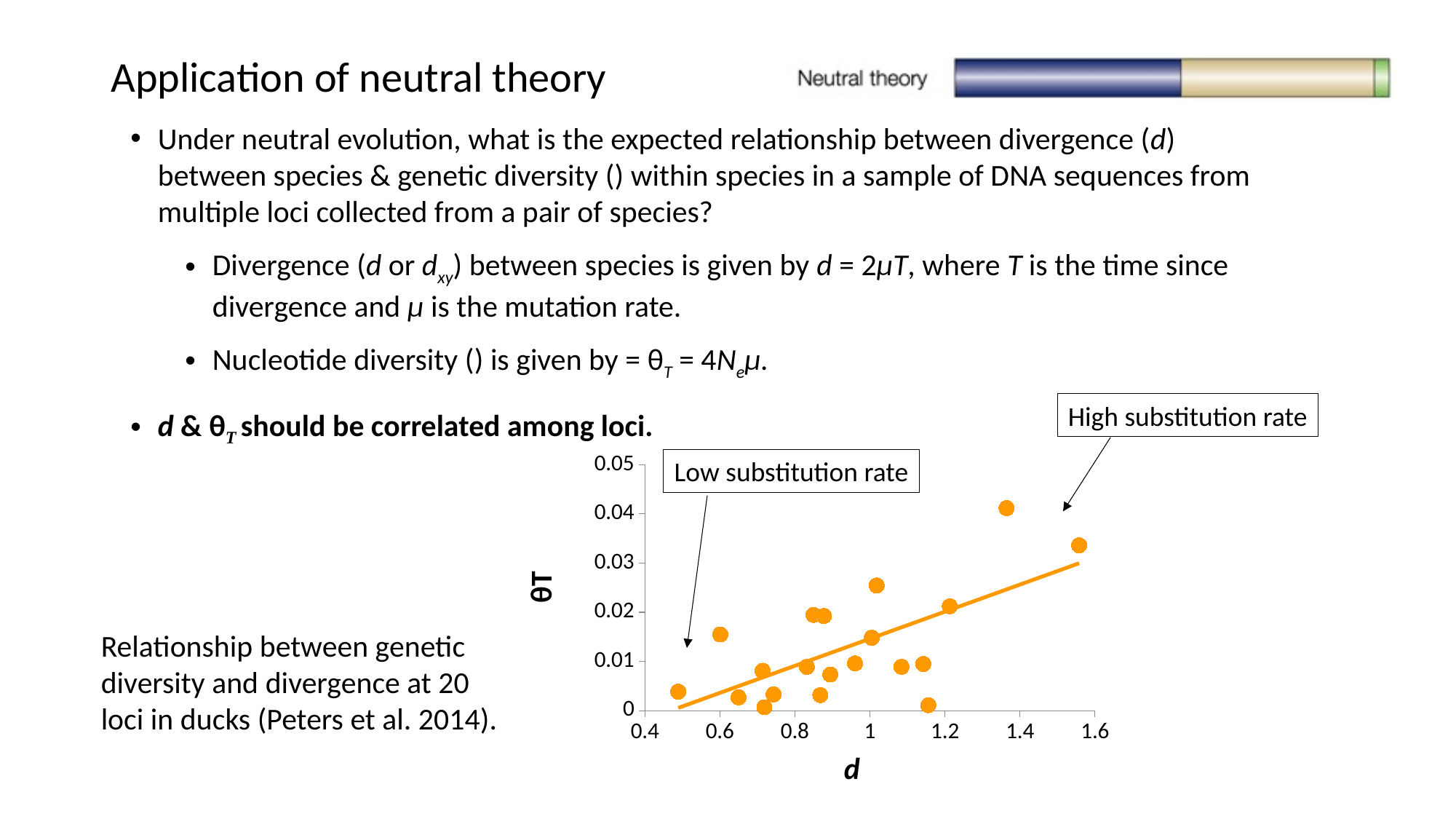
Which has the higher θT value: the point at d ≈ 1.36 or the point at d ≈ 1.21? the point at d ≈ 1.36 What is the label of the y axis of the chart? θT What is the maximum value shown on the y axis of the chart? 0.05 Is the d value of the leftmost point greater or less than 0.6? less Does θT tend to rise or fall as d increases along the x axis? rise Is the θT value of the point at d ≈ 1.55 greater or less than 0.03? greater How many data points (loci) are plotted in the chart? 20 What kind of chart is shown on the slide? scatter plot Is the θT value of the point at d ≈ 0.6 greater or less than 0.02? less What is the label of the x axis of the chart? d